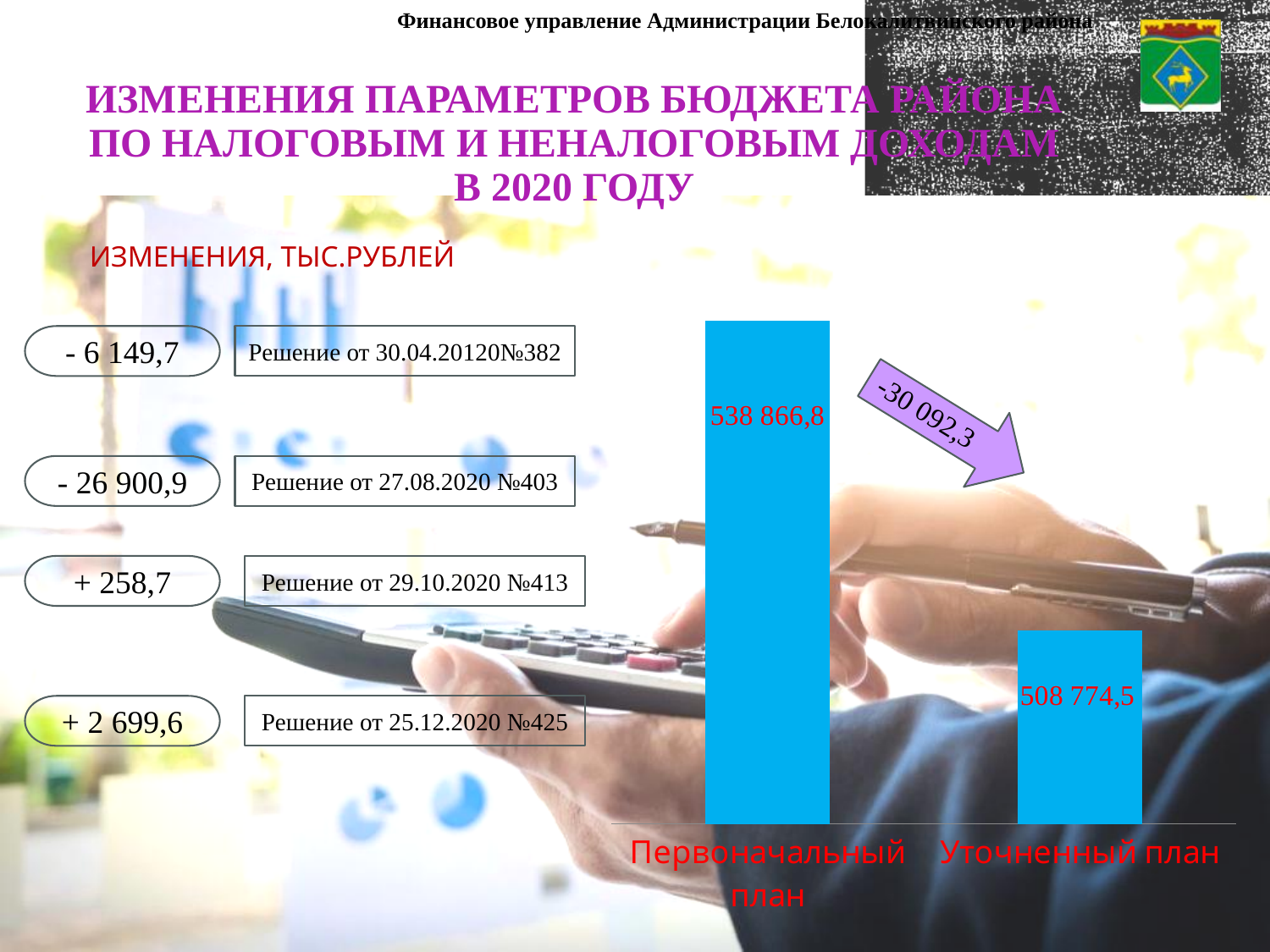
Do the values rise or fall from Первоначальный план to Уточненный план? fall Which category has the lowest value in the chart? Уточненный план What is the difference between Первоначальный план and Уточненный план? 30 092,3 What is the value for Уточненный план? 508 774,5 How many bars are plotted in the chart? 2 Which category has the highest value in the chart? Первоначальный план What kind of chart is shown on the slide? bar chart What is the value for Первоначальный план? 538 866,8 What value is written on the arrow between the two bars? -30 092,3 Which category has the higher value, Первоначальный план or Уточненный план? Первоначальный план What colour are the bars in the chart? blue